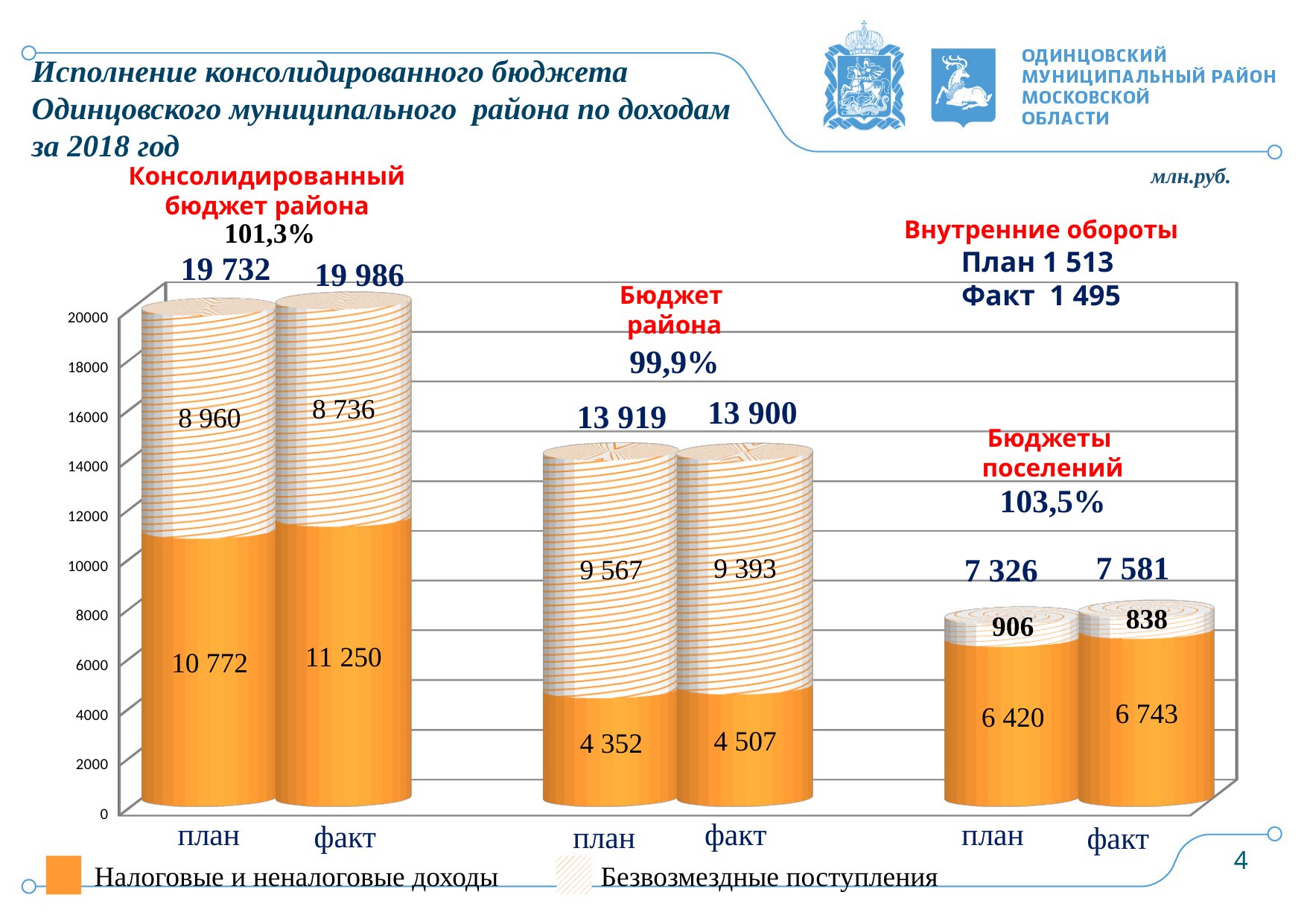
What is the value of Безвозмездные поступления for the план bar of Бюджеты поселений? 906 What is the total of the факт bar for Консолидированный бюджет района? 19 986 Which is larger: Безвозмездные поступления for план or for факт in Консолидированный бюджет района? план What kind of chart is shown on the slide? stacked bar chart What is the value of Налоговые и неналоговые доходы for the план bar of Консолидированный бюджет района? 10 772 How many series does the legend list? 2 What is the total of the план bar for Бюджеты поселений? 7 326 How many bars are plotted on the chart? 6 What is the value of Безвозмездные поступления for the факт bar of Бюджет района? 9 393 What is the difference between the факт and план values of Налоговые и неналоговые доходы for Бюджет района? 155 Which bar has the lowest total value? план for Бюджеты поселений Which bar has the highest total value? факт for Консолидированный бюджет района